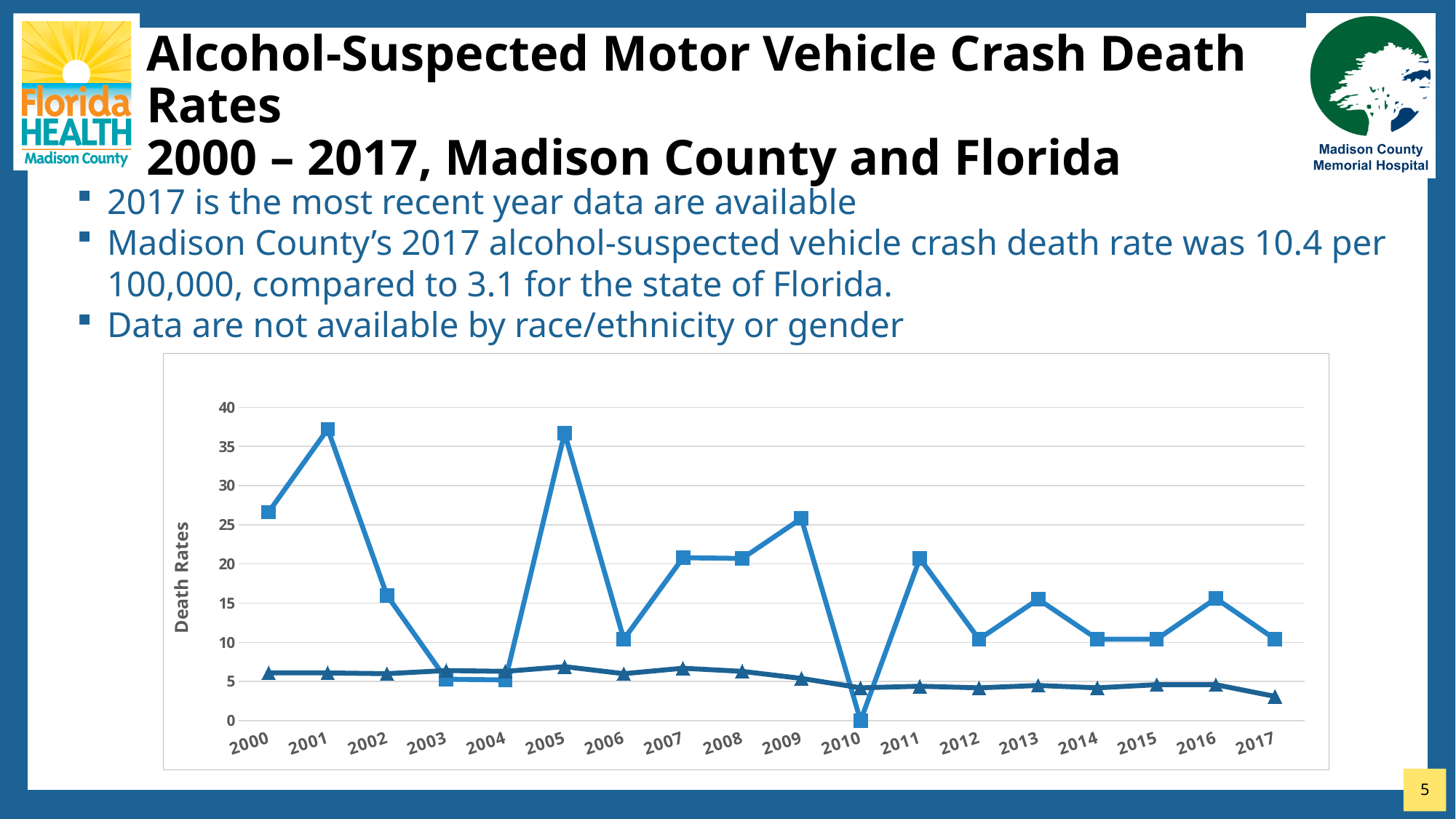
In 2005, which line has the higher value: the line with square markers or the line with triangle markers? the line with square markers How many lines are plotted on the chart? 2 In which year does the line with square markers reach its lowest value? 2010 Is the value of the line with square markers in 2001 greater or less than 35? greater What kind of chart is shown on the slide? line chart Is the value of the line with triangle markers in 2005 greater or less than 10? less How many years are plotted along the x axis of the chart? 18 What is the title of the vertical axis of the chart? Death Rates Is the value of the line with square markers in 2009 greater or less than 20? greater Does the line with triangle markers generally rise or fall from 2000 to 2017? fall According to the slide, what was Madison County's alcohol-suspected vehicle crash death rate in 2017? 10.4 per 100,000 What is the value of the line with square markers in 2010? 0